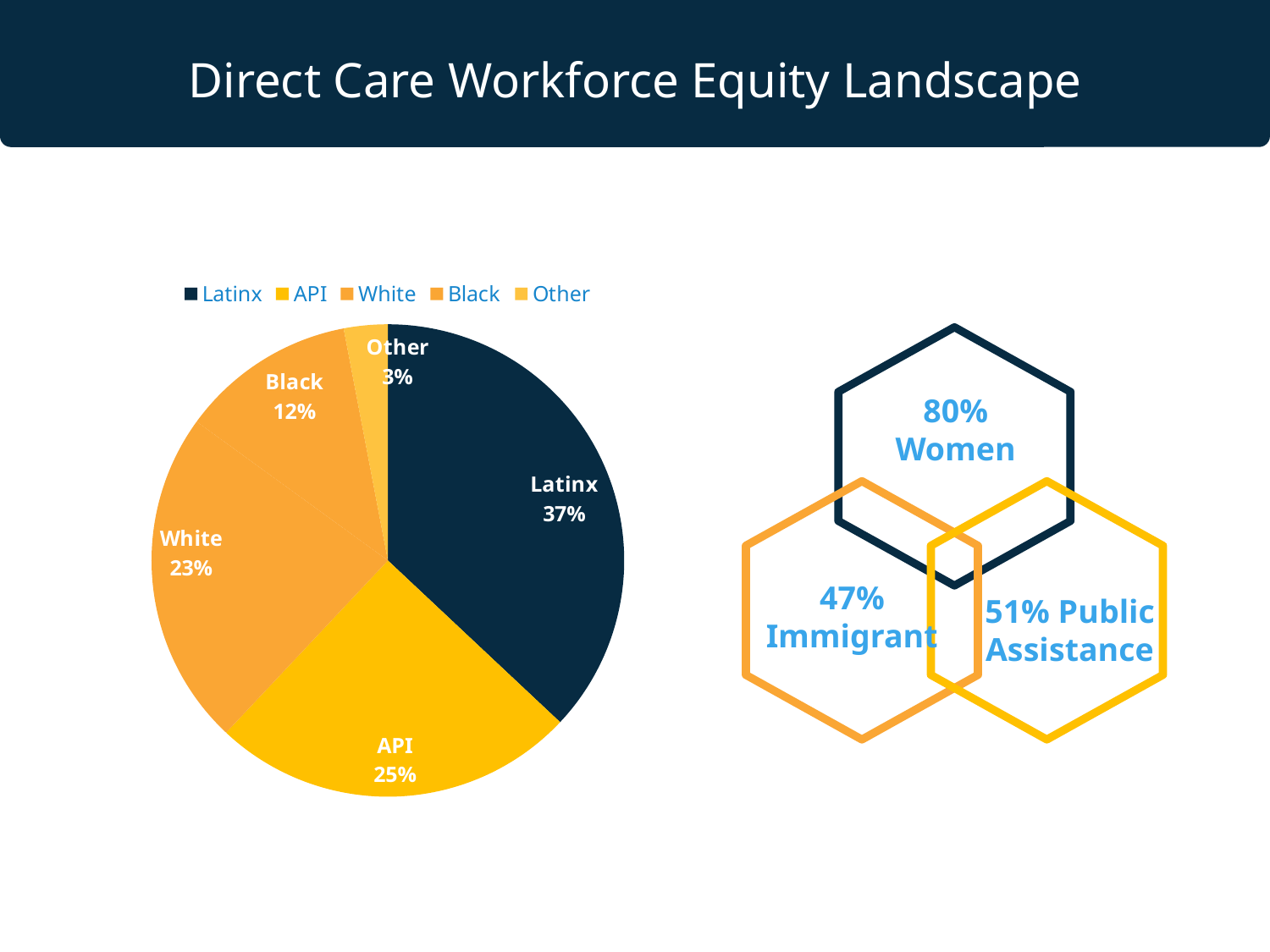
What is the difference in percentage points between the Latinx and API slices? 12 What percentage of the pie chart is Latinx? 37% Which category has the largest slice of the pie chart? Latinx What percentage of the pie chart is White? 23% What percentage of the pie chart is Black? 12% Which slice is larger, White or Black? White How many categories does the pie chart show? 5 What kind of chart is shown on the slide? pie chart What percentage of the pie chart is Other? 3% Which category has the smallest slice of the pie chart? Other What percentage of the pie chart is API? 25% How many entries are listed in the pie chart's legend? 5